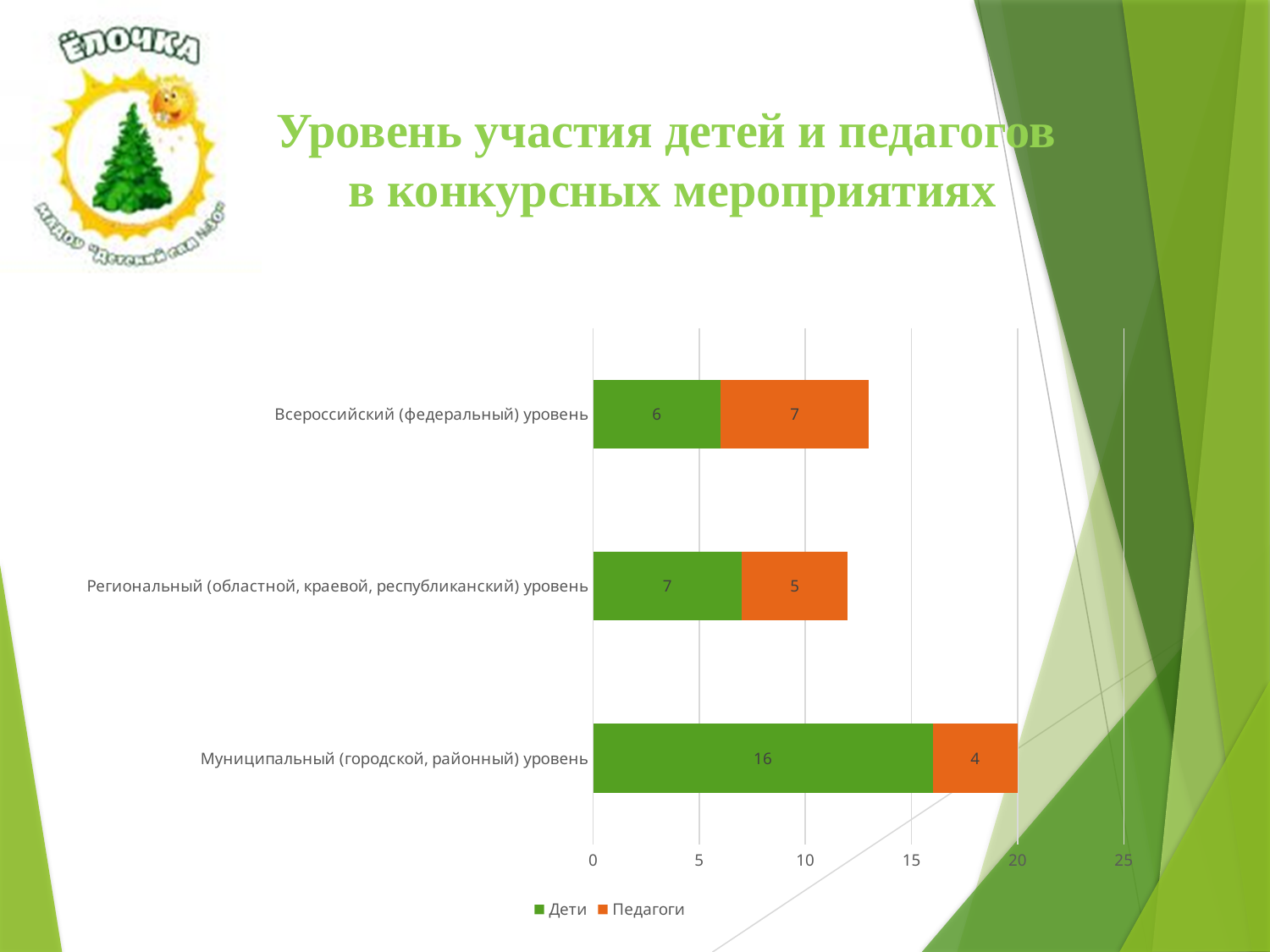
What is the value for Педагоги at the Всероссийский (федеральный) уровень? 7 What is the total of the stacked bar for the Муниципальный (городской, районный) уровень? 20 Which level has the lowest value for Педагоги? Муниципальный (городской, районный) уровень What is the value for Дети at the Муниципальный (городской, районный) уровень? 16 Which is larger at the Региональный level: Дети or Педагоги? Дети What is the difference between the Дети values for the Муниципальный level and the Всероссийский level? 10 What is the value for Педагоги at the Региональный (областной, краевой, республиканский) уровень? 5 How many categories (levels) are shown on the chart? 3 How many series does the legend list? 2 What is the total of the stacked bar for the Всероссийский (федеральный) уровень? 13 What kind of chart is shown on the slide? Stacked bar chart Which level has the highest value for Дети? Муниципальный (городской, районный) уровень